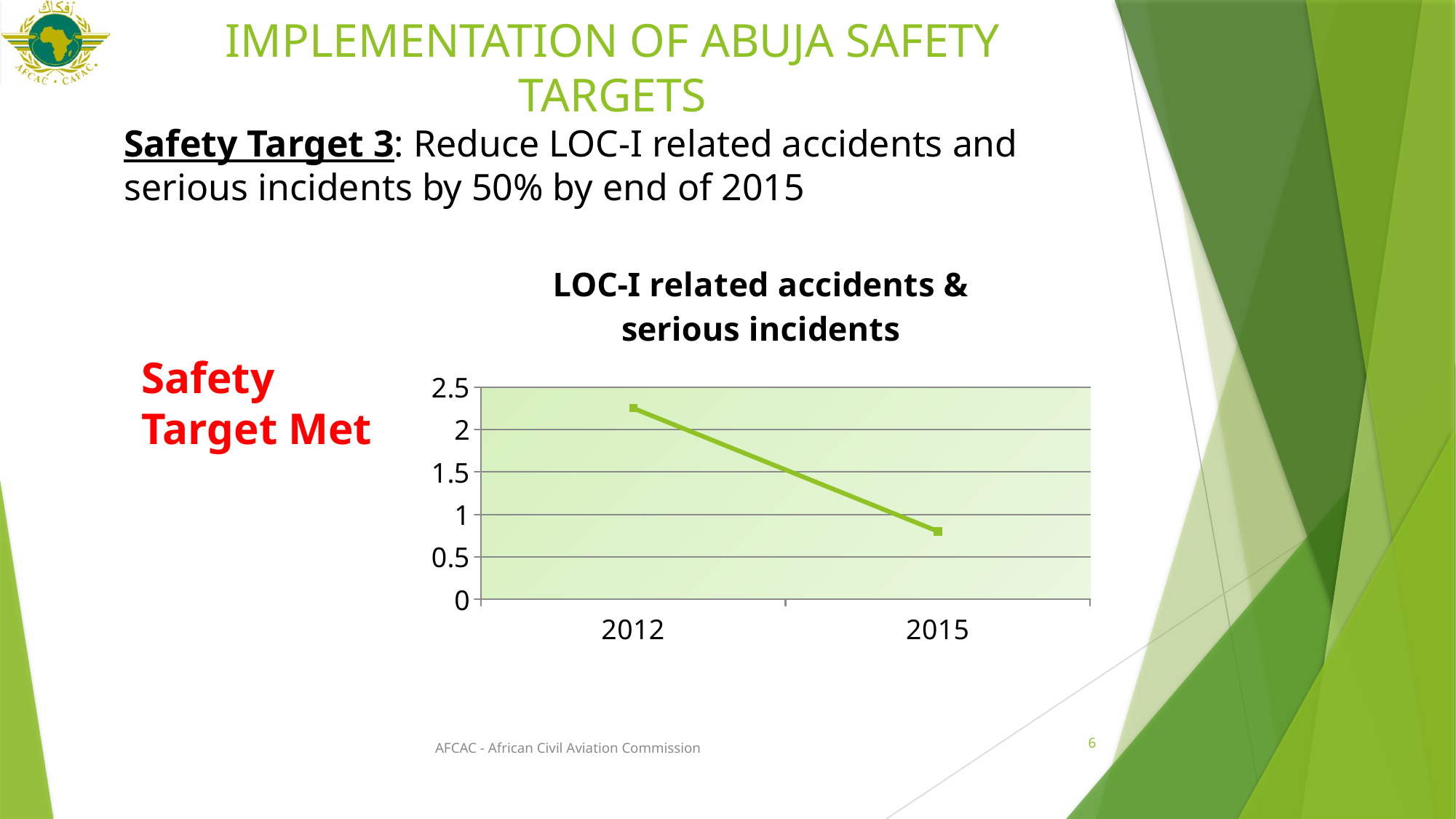
What is the title of the chart? LOC-I related accidents & serious incidents What kind of chart is shown on the slide? line chart How many data points are plotted on the chart? 2 Which year has the highest value on the chart? 2012 Is the value for 2015 greater or less than 1? less Do the values rise or fall from 2012 to 2015? fall What is the highest value shown on the vertical axis of the chart? 2.5 Which year has the lowest value on the chart? 2015 Is the value for 2012 greater or less than 2.5? less Is the value for 2015 greater or less than 0.5? greater Which year has the higher value on the chart, 2012 or 2015? 2012